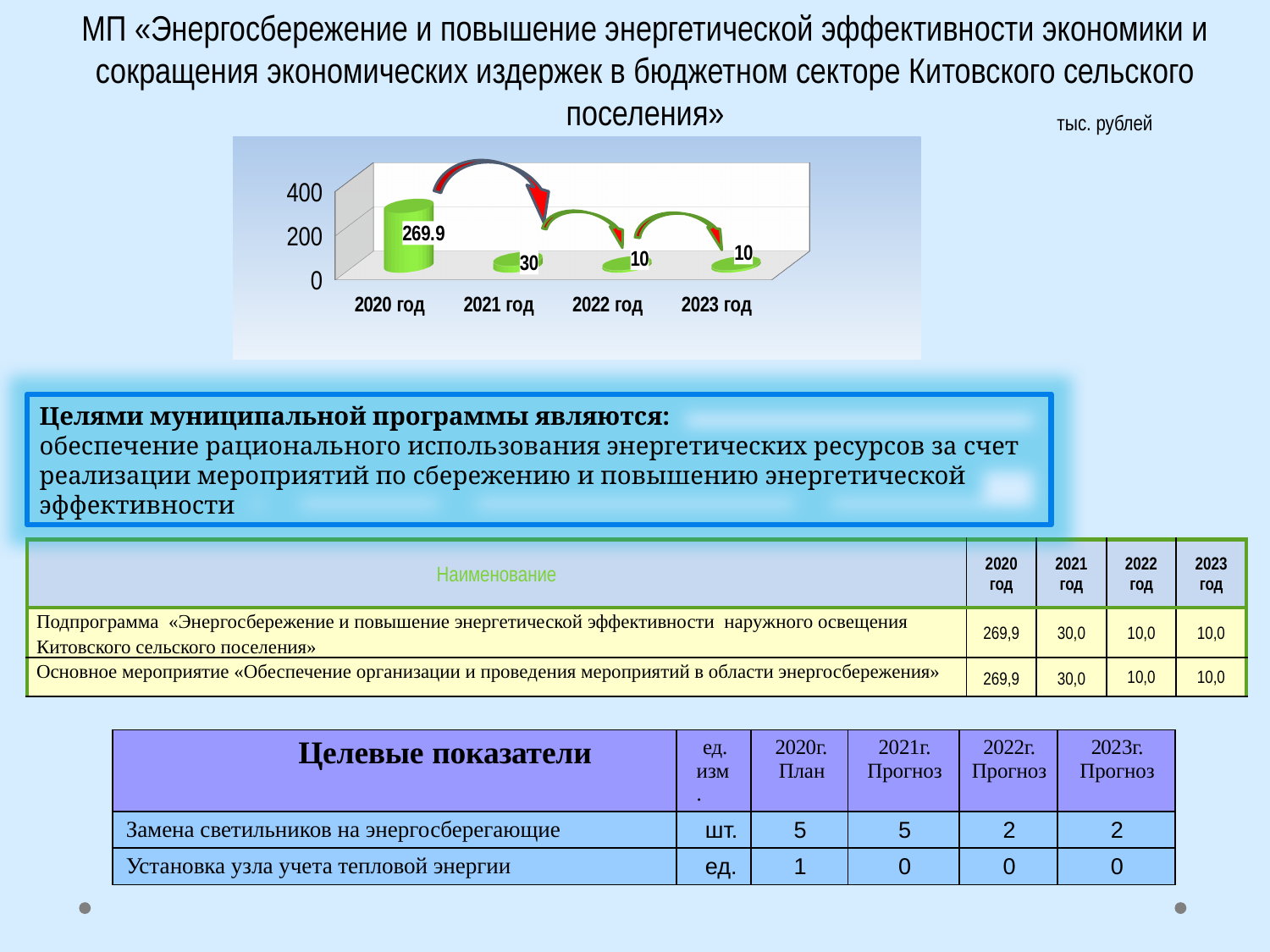
What is the value shown for 2023 год on the chart? 10 Do the values on the chart rise or fall from 2020 год to 2023 год? fall What is the value shown for 2020 год on the chart? 269.9 Is the value for 2020 год on the chart greater or less than 200? greater How many years are shown on the x axis of the chart? 4 What is the difference between the values for 2021 год and 2022 год on the chart? 20 What is the difference between the values for 2020 год and 2021 год on the chart? 239.9 Which year has the highest value on the chart? 2020 год Which is larger on the chart, the value for 2021 год or the value for 2022 год? 2021 год What type of chart is shown on the slide? bar chart What unit is indicated for the chart values on the slide? тыс. рублей What is the value shown for 2021 год on the chart? 30